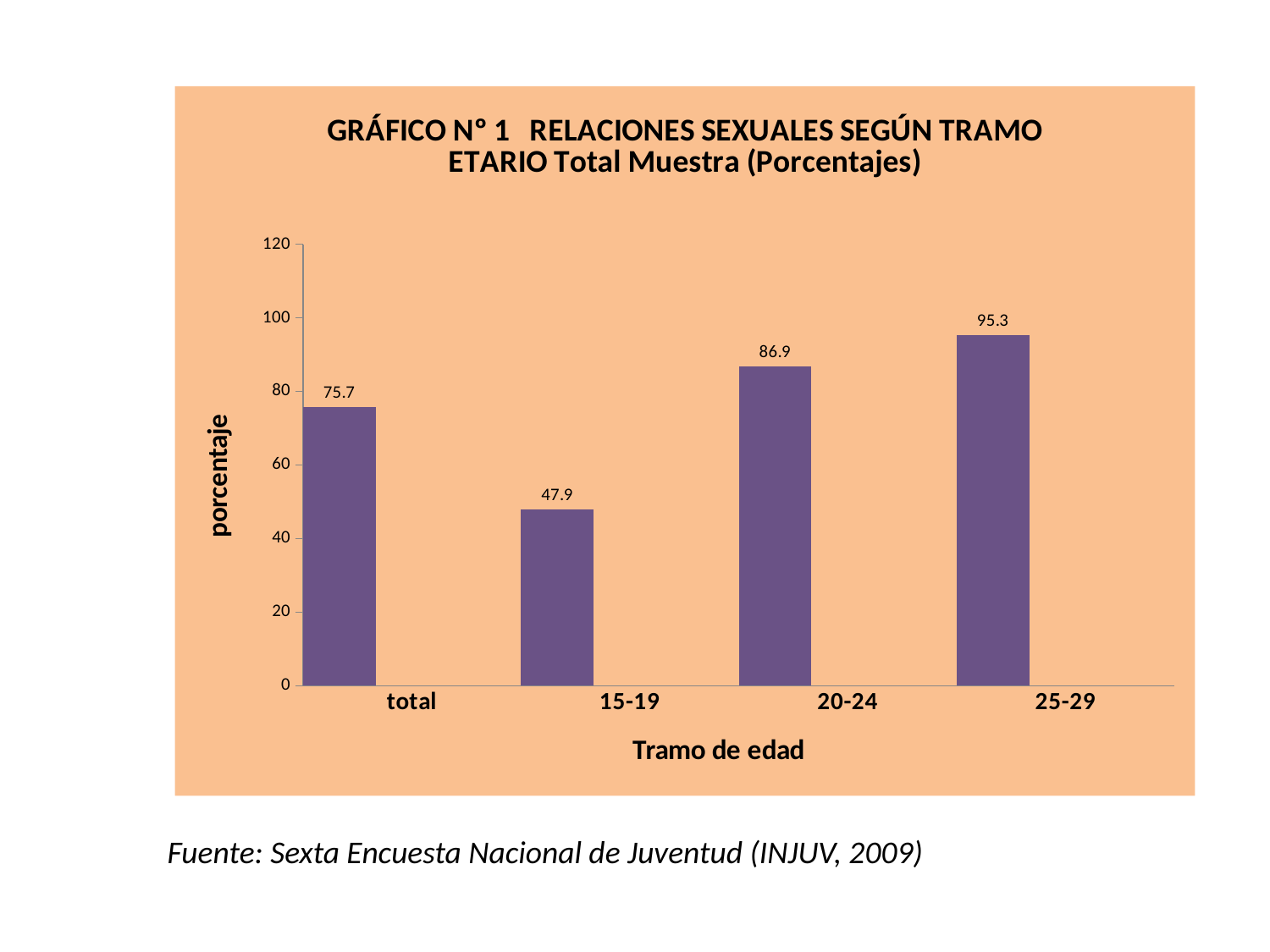
Which is larger, the value for 20-24 or the value for total? 20-24 What is the difference between the values for 20-24 and total? 11.2 What is the label of the x axis? Tramo de edad Which age group has the highest value? 25-29 What is the value for the 15-19 age group? 47.9 What kind of chart is shown on the slide? bar chart Is the value for 15-19 greater or less than 60? less How many categories are shown on the x axis? 4 What is the value for the 25-29 age group? 95.3 What is the difference between the values for 25-29 and 15-19? 47.4 What is the value for the 'total' category? 75.7 Which category has the lowest value? 15-19